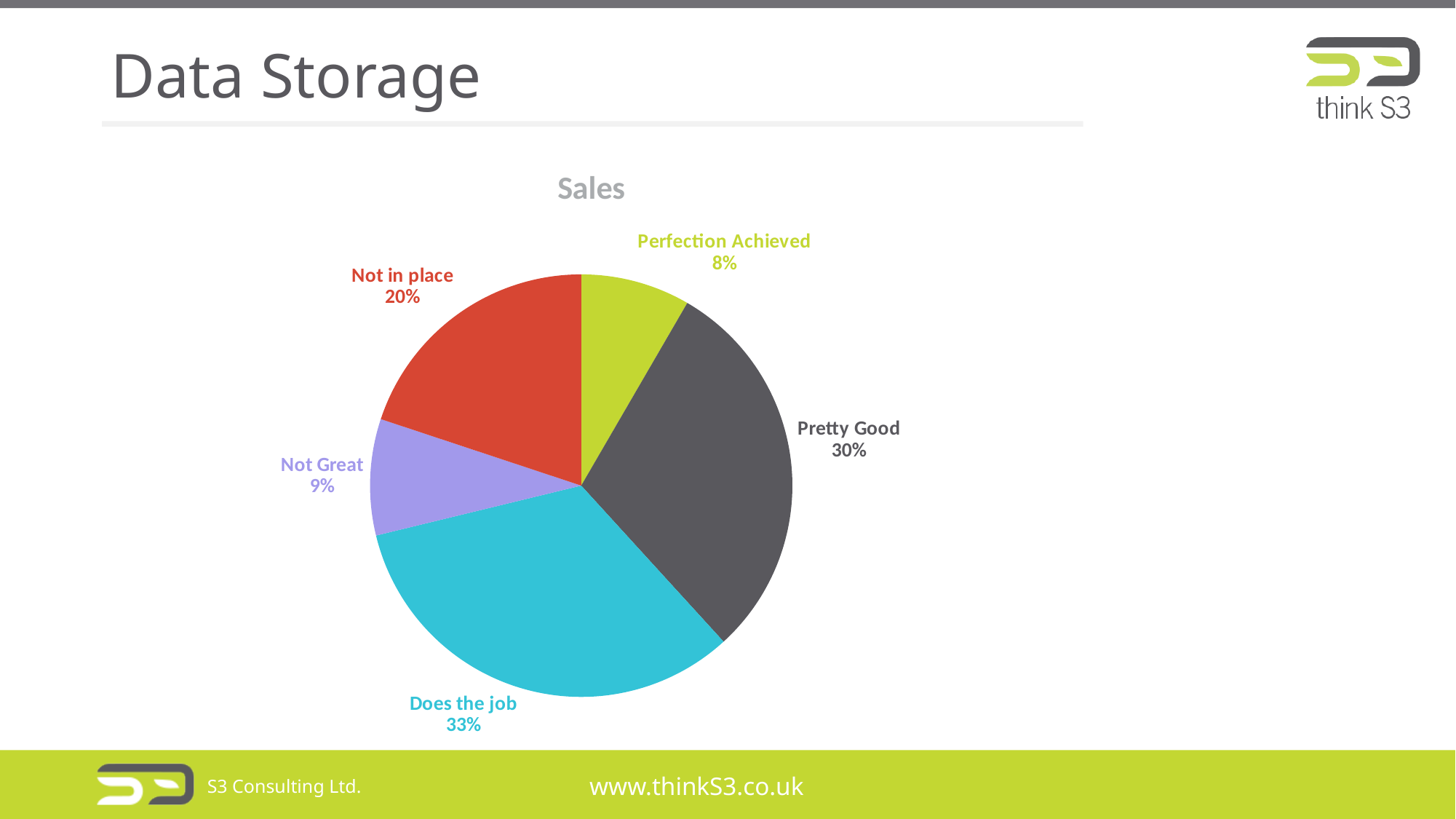
Which is larger, 'Not Great' or 'Not in place'? Not in place What is the title of the chart? Sales What percentage does the 'Perfection Achieved' slice represent? 8% What is the difference in percentage points between 'Does the job' and 'Not in place'? 13 What percentage does the 'Pretty Good' slice represent? 30% How many slices does the pie chart have? 5 What percentage does the 'Does the job' slice represent? 33% Which category has the largest share of the pie? Does the job What percentage does the 'Not in place' slice represent? 20% What colour is the 'Not Great' slice? purple Which category has the smallest share of the pie? Perfection Achieved What type of chart is shown on the slide? pie chart